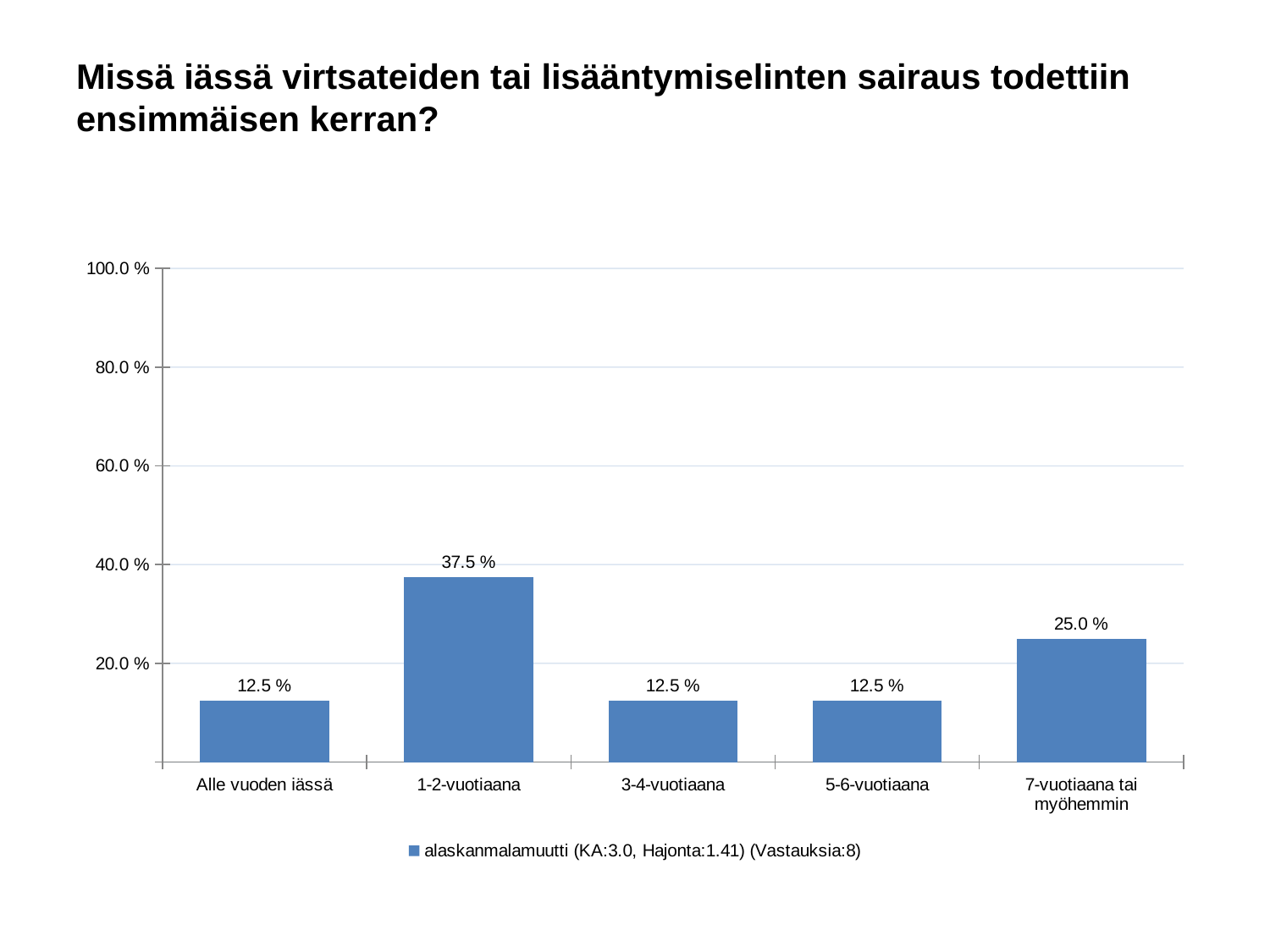
What is the difference between the values for 1-2-vuotiaana and 7-vuotiaana tai myöhemmin? 12.5 % What is the value for 7-vuotiaana tai myöhemmin? 25.0 % Which category has the highest value? 1-2-vuotiaana What kind of chart is shown? bar chart How many categories are shown on the x axis? 5 What is the value for 1-2-vuotiaana? 37.5 % Which is larger, the value for 3-4-vuotiaana or the value for 7-vuotiaana tai myöhemmin? 7-vuotiaana tai myöhemmin Is the value for 1-2-vuotiaana greater or less than 20.0 %? greater How many responses (Vastauksia) does the legend entry report? 8 How many series does the legend list? 1 What is the value for Alle vuoden iässä? 12.5 % Is the value for 5-6-vuotiaana greater or less than 20.0 %? less